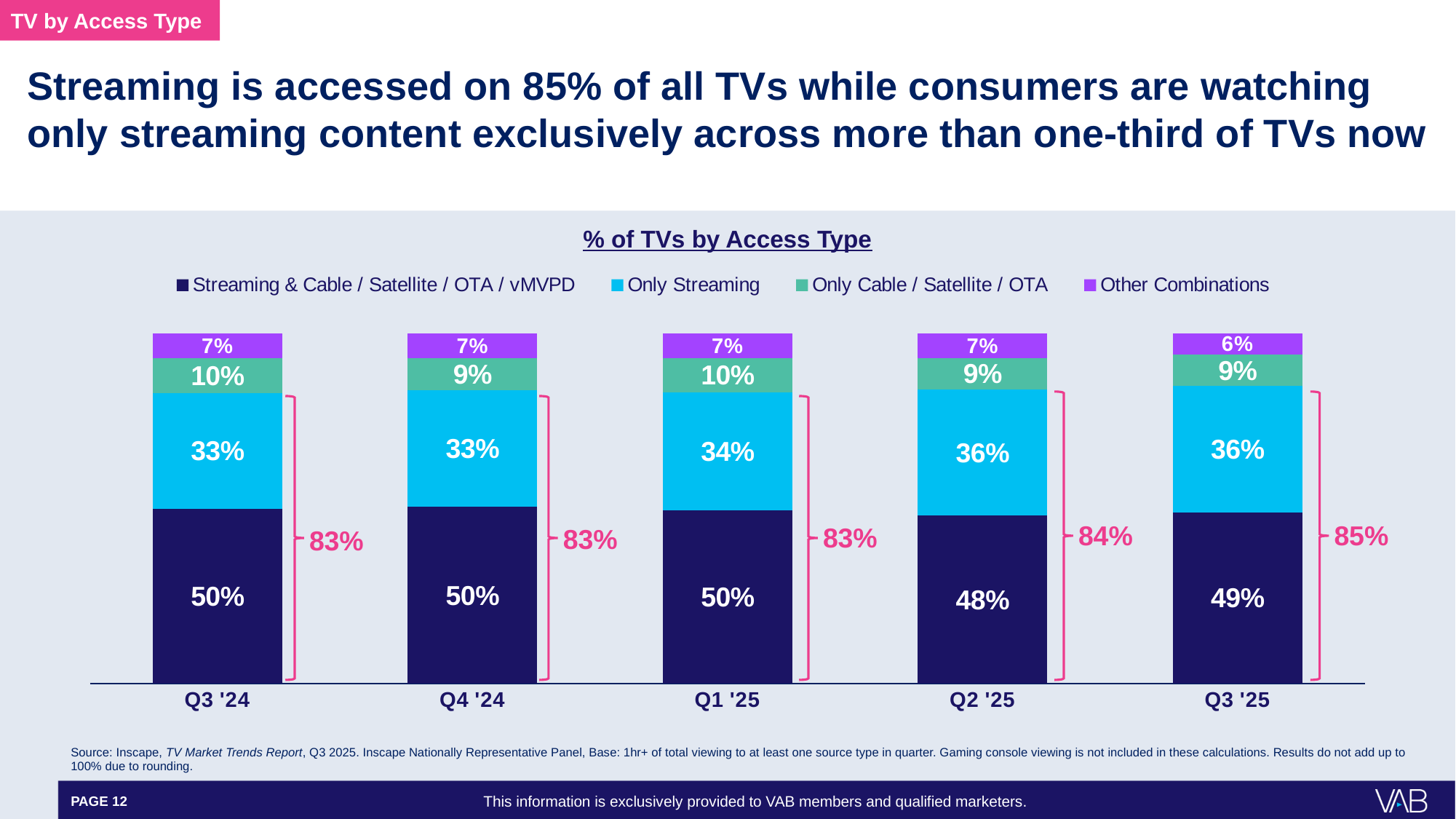
What is the value for Streaming & Cable / Satellite / OTA / vMVPD in Q2 '25? 48% What is the value for Only Streaming in Q3 '25? 36% What is the value for Only Cable / Satellite / OTA in Q1 '25? 10% How many series does the legend list? 4 Which is larger: Only Streaming in Q2 '25 or Only Streaming in Q1 '25? Q2 '25 Does the Only Streaming value rise or fall from Q3 '24 to Q3 '25? Rise What kind of chart is shown? Stacked bar chart How many quarters are shown on the x axis? 5 In which quarter is the Only Streaming value lowest? Q3 '24 and Q4 '24 What is the chart's title? % of TVs by Access Type What is the difference between the Only Streaming values in Q3 '25 and Q3 '24? 3% What is the value for Other Combinations in Q3 '25? 6%